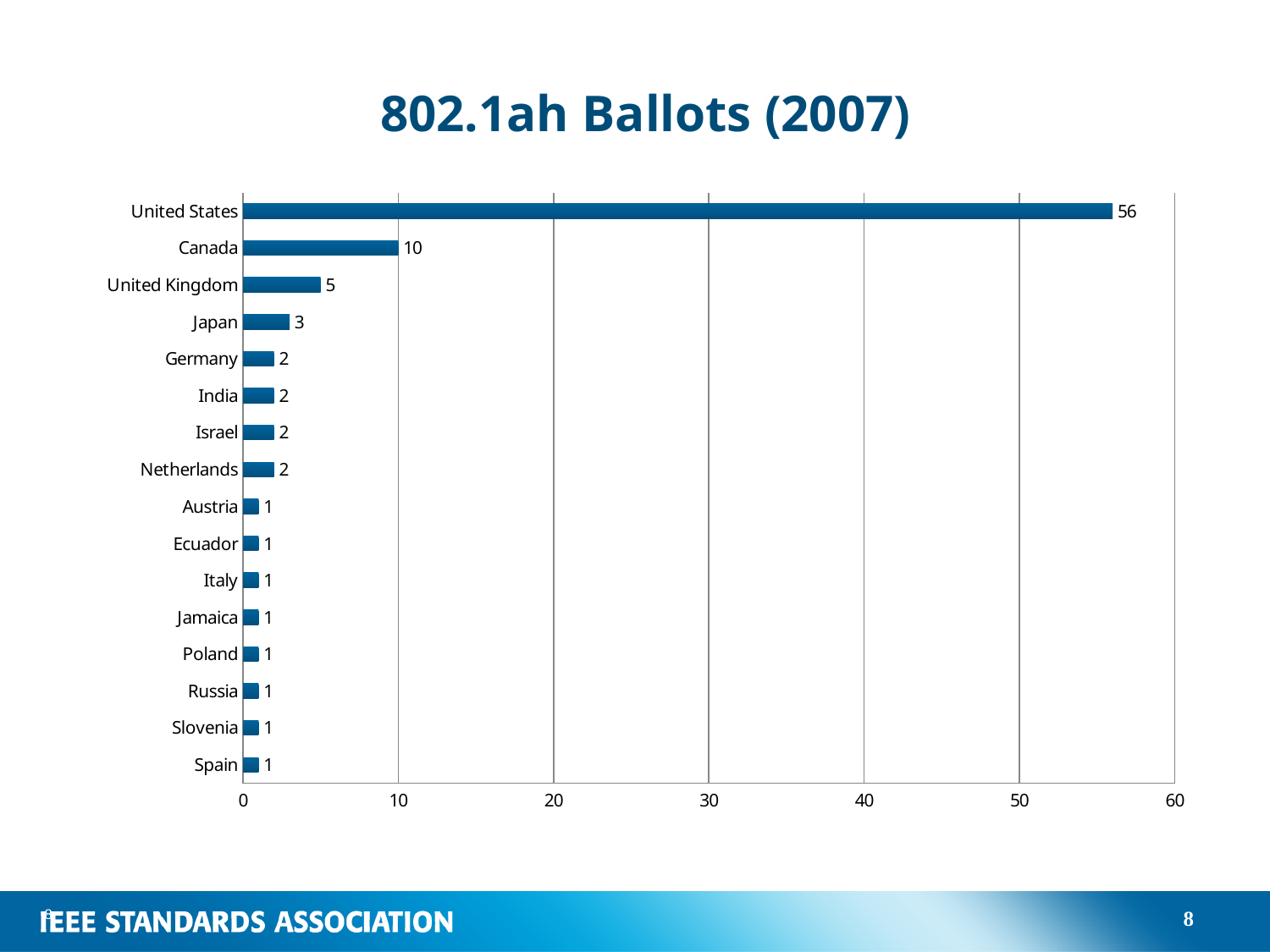
Which country has the highest value? United States What is the difference between the values for United Kingdom and Japan? 2 What is the difference between the values for United States and Canada? 46 What is the value for Japan? 3 What kind of chart is shown on the slide? bar chart What is the value for Canada? 10 Is the value for United States greater or less than 50? greater How many countries are shown in the chart? 16 What is the title of the chart? 802.1ah Ballots (2007) What is the value for Netherlands? 2 Which is larger, the value for Canada or the value for United Kingdom? Canada What is the value for United States? 56